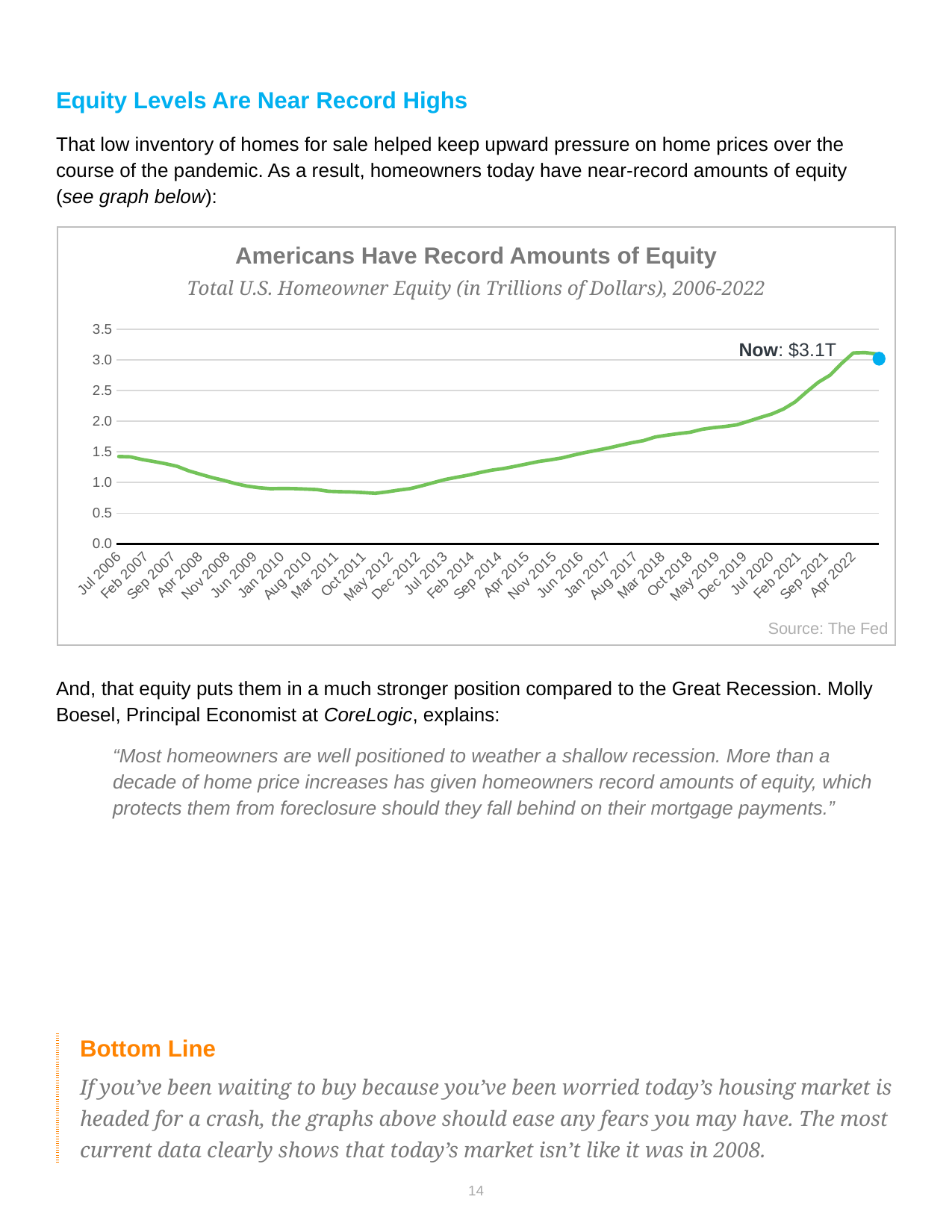
What is the current ("Now") value of total U.S. homeowner equity shown on the chart? $3.1T Do the values rise or fall along the x axis from Dec 2012 to Apr 2022? rise Which is larger, the value for Jul 2006 or the value for Oct 2011? Jul 2006 Which is larger, the value for Jul 2006 or the value for Apr 2022? Apr 2022 What kind of chart is shown on the slide? line chart What is the title of the chart? Americans Have Record Amounts of Equity Is the value for Oct 2011 greater or less than 1.0? less Is the value for Mar 2018 greater or less than 1.5? greater What is the source cited for the chart? The Fed Is the value for Sep 2021 greater or less than 2.5? greater